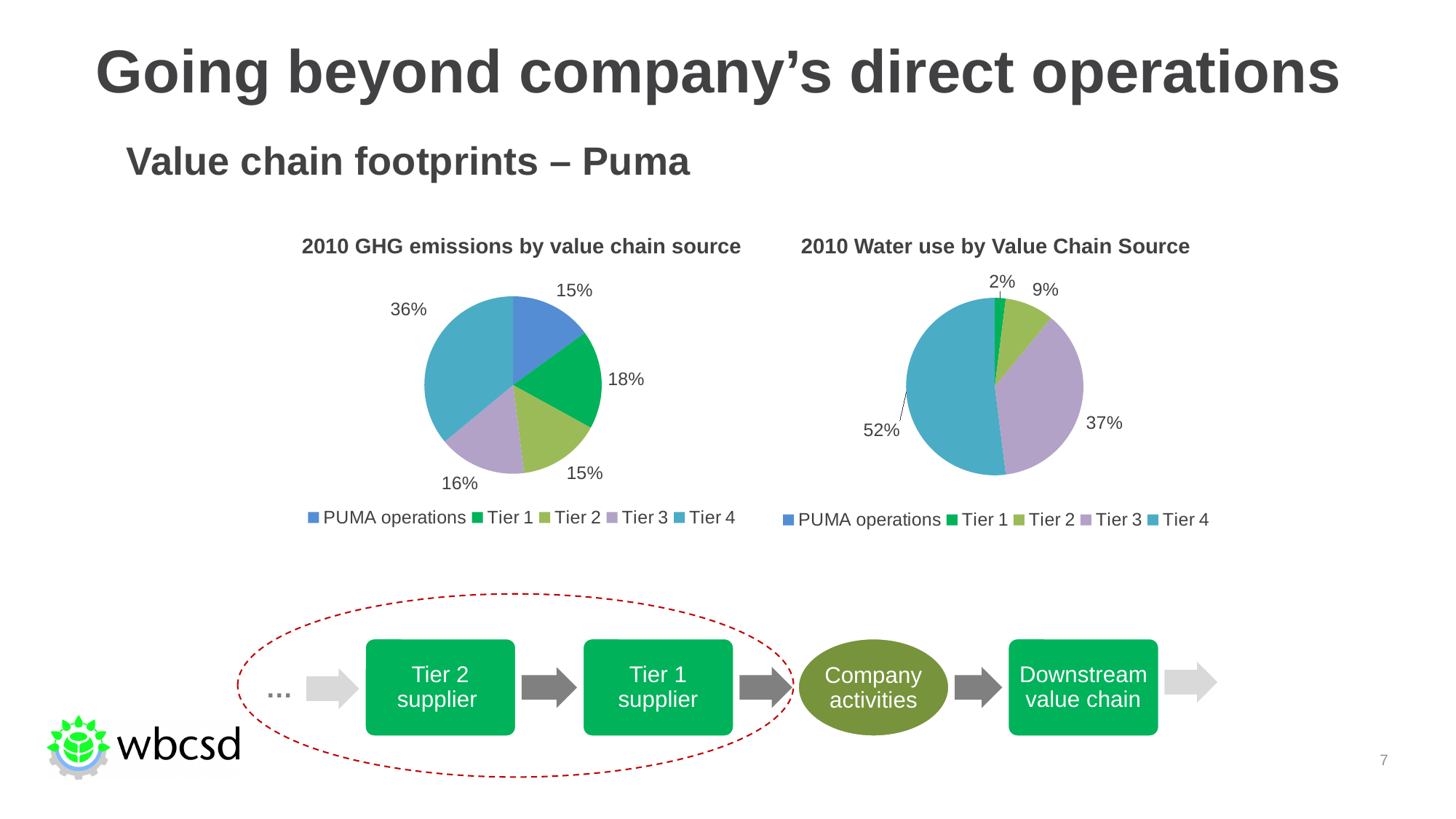
In the '2010 GHG emissions by value chain source' chart, which source has the largest share? Tier 4 In the '2010 Water use by Value Chain Source' chart, what share of water use comes from Tier 3? 37% In the '2010 GHG emissions by value chain source' chart, what is the difference between the Tier 4 share and the Tier 1 share? 18% In the '2010 GHG emissions by value chain source' chart, what colour is the Tier 4 slice? Teal blue How many entries does the legend of the '2010 GHG emissions by value chain source' chart list? 5 What kind of chart is the '2010 Water use by Value Chain Source' chart? Pie chart In the '2010 Water use by Value Chain Source' chart, what share of water use comes from Tier 1? 2% In the '2010 GHG emissions by value chain source' chart, which is larger, the Tier 1 share or the Tier 3 share? Tier 1 In the '2010 Water use by Value Chain Source' chart, what is the difference between the Tier 4 share and the Tier 2 share? 43% In the '2010 GHG emissions by value chain source' chart, what share of emissions comes from Tier 4? 36% In the '2010 GHG emissions by value chain source' chart, what share of emissions comes from PUMA operations? 15% In the '2010 Water use by Value Chain Source' chart, which source has the largest share? Tier 4